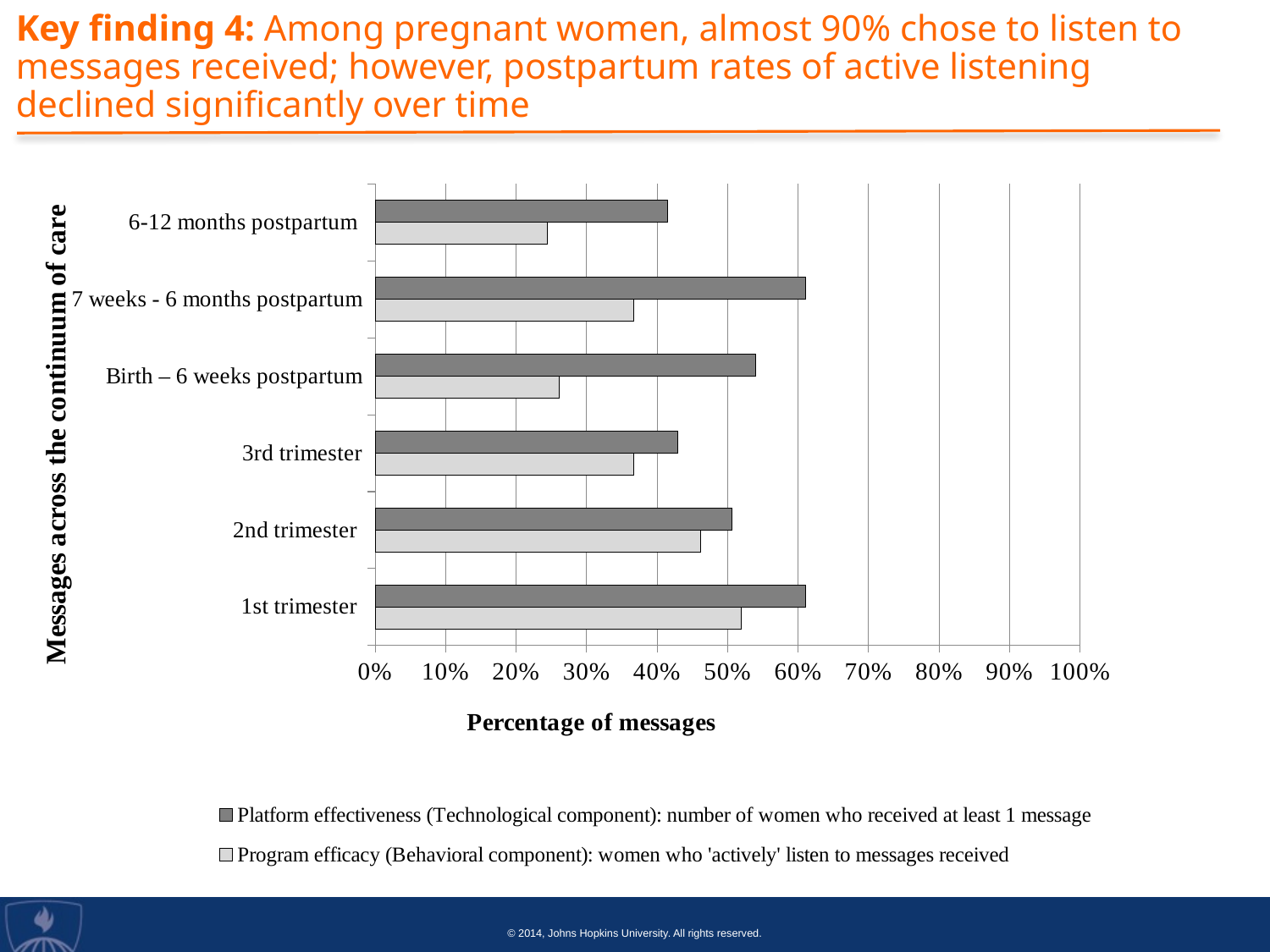
Is the Program efficacy value for 1st trimester greater or less than 50%? greater What is the title of the vertical axis? Messages across the continuum of care What kind of chart is shown on the slide? bar chart Which has the larger Program efficacy value: 1st trimester or 6-12 months postpartum? 1st trimester Which category has the highest Program efficacy value? 1st trimester How many categories are shown on the vertical axis of the chart? 6 How many series does the legend list? 2 Is the Program efficacy value for 6-12 months postpartum greater or less than 30%? less Which is larger for 6-12 months postpartum: the Platform effectiveness value or the Program efficacy value? Platform effectiveness Is the Platform effectiveness value for 3rd trimester greater or less than 50%? less What is the title of the horizontal axis? Percentage of messages